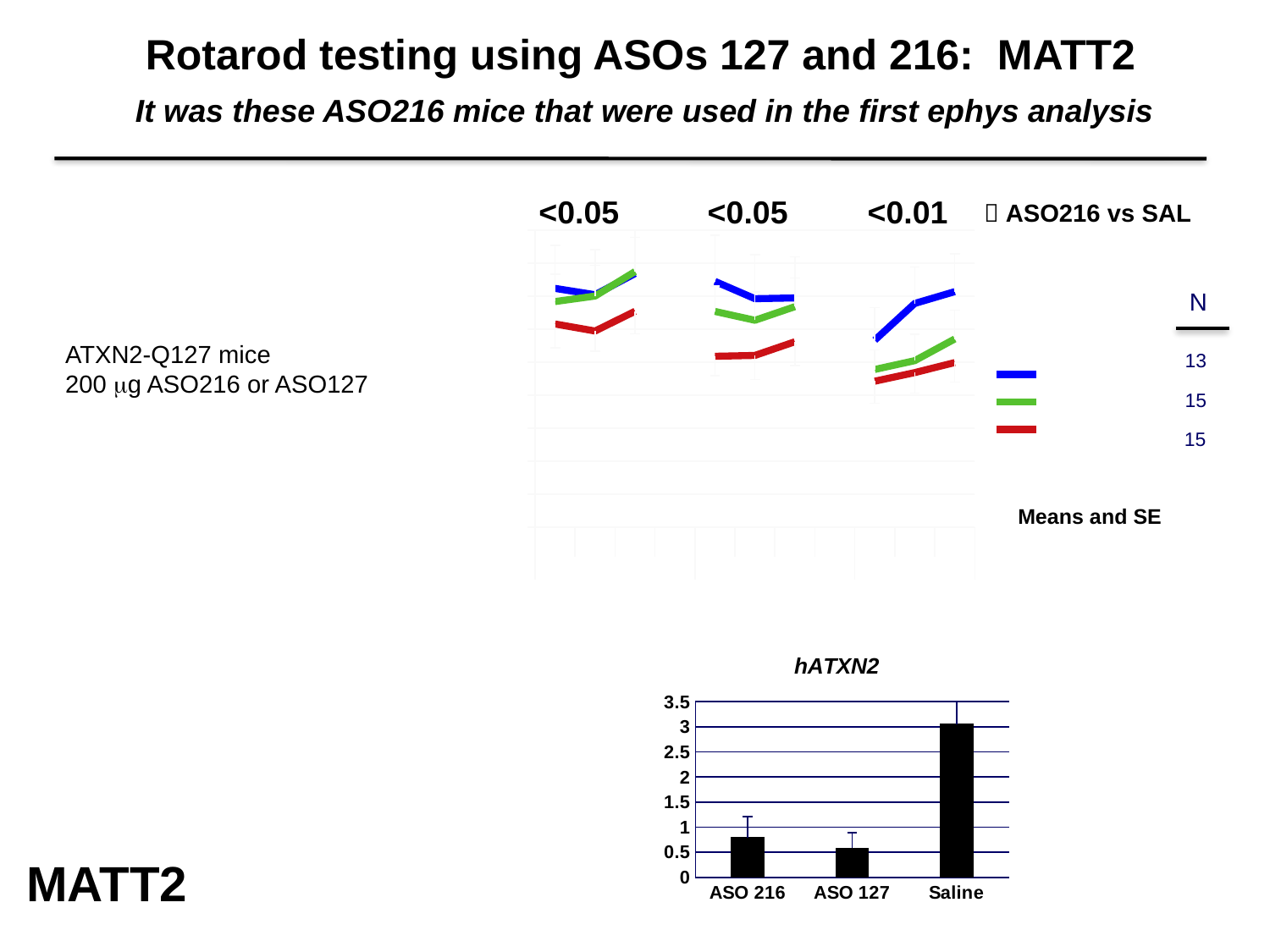
What kind of chart is the upper chart on the slide (the rotarod chart)? line chart In the hATXN2 bar chart, is the value for ASO 127 greater or less than 1? less In the hATXN2 bar chart, which category has the lowest value? ASO 127 In the hATXN2 bar chart, is the value for Saline greater or less than 2.5? greater In the hATXN2 bar chart, is the value for ASO 216 greater or less than 0.5? greater What kind of chart is the hATXN2 chart at the bottom of the slide? bar chart How many series does the legend of the upper rotarod line chart show? 3 What is the title of the bar chart at the bottom of the slide? hATXN2 How many categories are shown in the hATXN2 bar chart? 3 In the hATXN2 bar chart, which category has the highest value? Saline In the hATXN2 bar chart, which is larger, the value for ASO 216 or the value for ASO 127? ASO 216